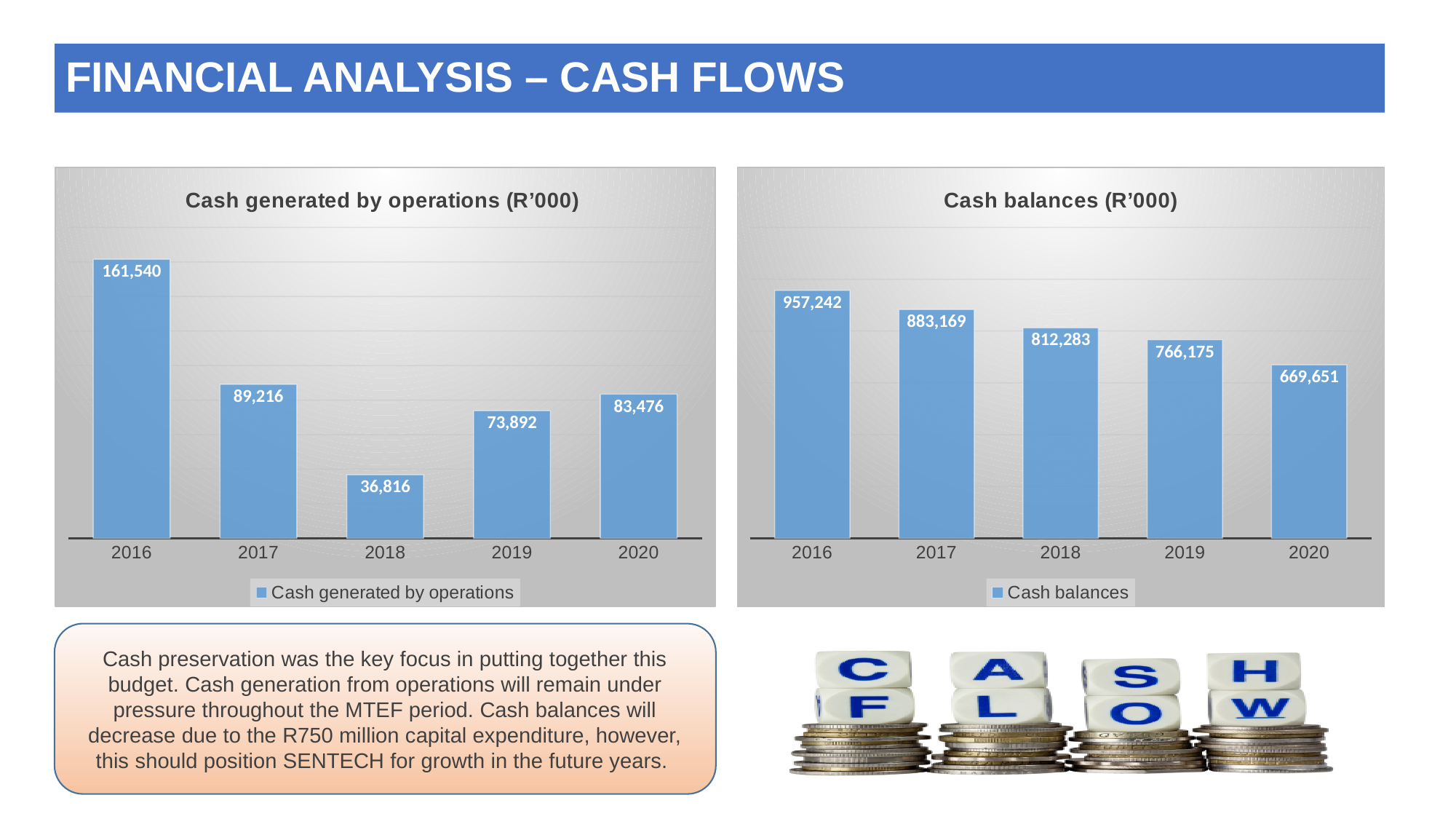
What kind of chart is the 'Cash balances (R'000)' chart? Bar chart In the 'Cash generated by operations (R'000)' chart, which year has the highest value? 2016 In the 'Cash balances (R'000)' chart, what is the value for 2019? 766,175 In the 'Cash generated by operations (R'000)' chart, what is the value for 2018? 36,816 In the 'Cash balances (R'000)' chart, what is the difference between the 2016 and 2020 values? 287,591 How many series does the legend of the 'Cash generated by operations (R'000)' chart list? 1 In the 'Cash generated by operations (R'000)' chart, which is larger, the value for 2019 or the value for 2020? 2020 In the 'Cash balances (R'000)' chart, do the values rise or fall from 2016 to 2020? Fall In the 'Cash generated by operations (R'000)' chart, which year has the lowest value? 2018 How many years are shown on the x axis of the 'Cash balances (R'000)' chart? 5 In the 'Cash balances (R'000)' chart, which year has the lowest value? 2020 In the 'Cash generated by operations (R'000)' chart, what is the difference between the 2017 and 2020 values? 5,740